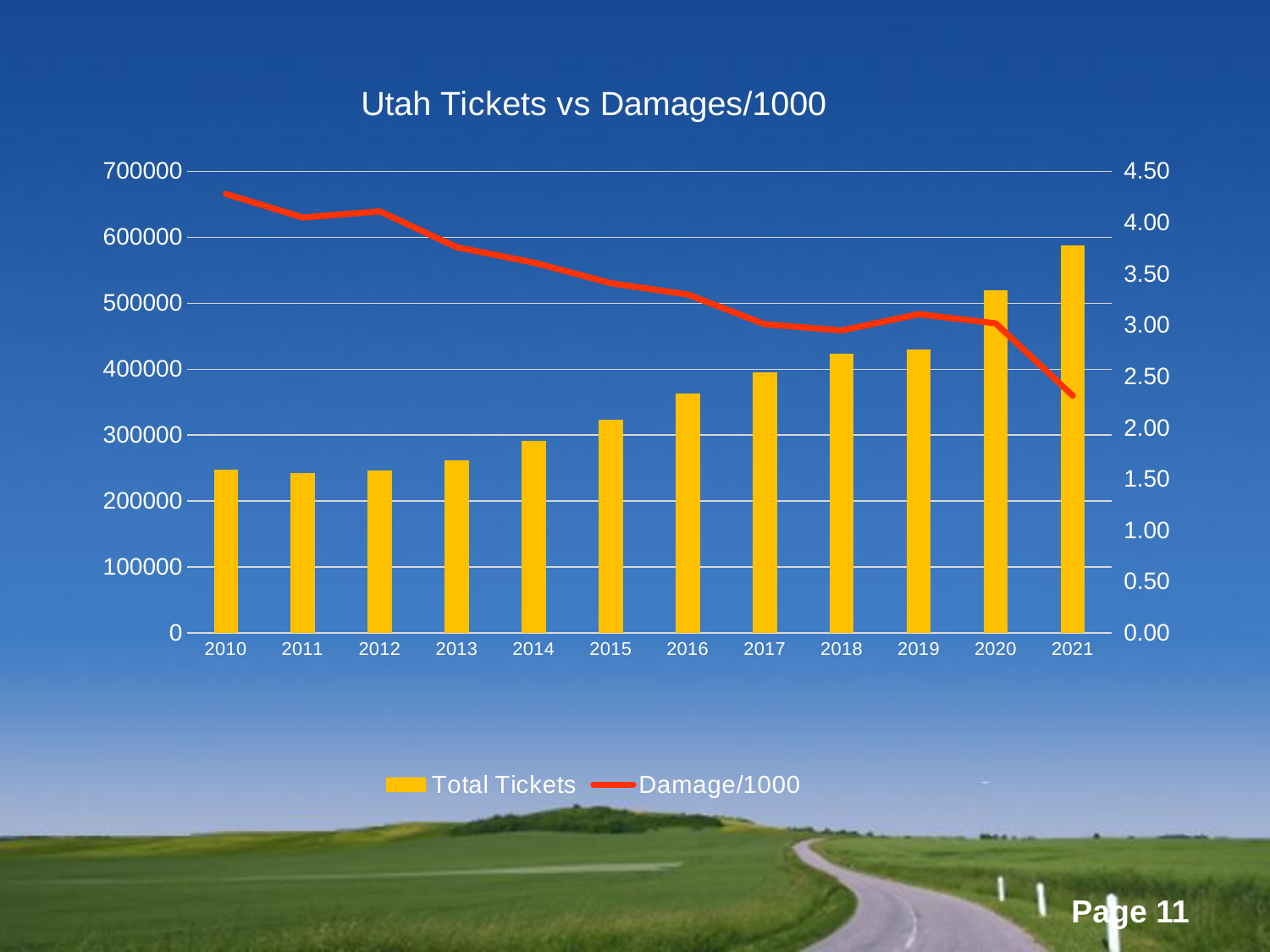
In which year is the Damage/1000 line at its highest? 2010 How many series does the legend list? 2 Is the Total Tickets value for 2021 greater or less than 500000? greater Which year has more Total Tickets, 2020 or 2019? 2020 Overall, does the Damage/1000 line rise or fall from 2010 to 2021? fall In which year is the Damage/1000 line at its lowest? 2021 Is the Damage/1000 value for 2021 greater or less than 2.50? less What kind of chart is shown on the slide? A combined bar and line chart Is the Damage/1000 value for 2010 greater or less than 4.00? greater How many years are shown on the x axis of the chart? 12 Which year has the highest Total Tickets bar? 2021